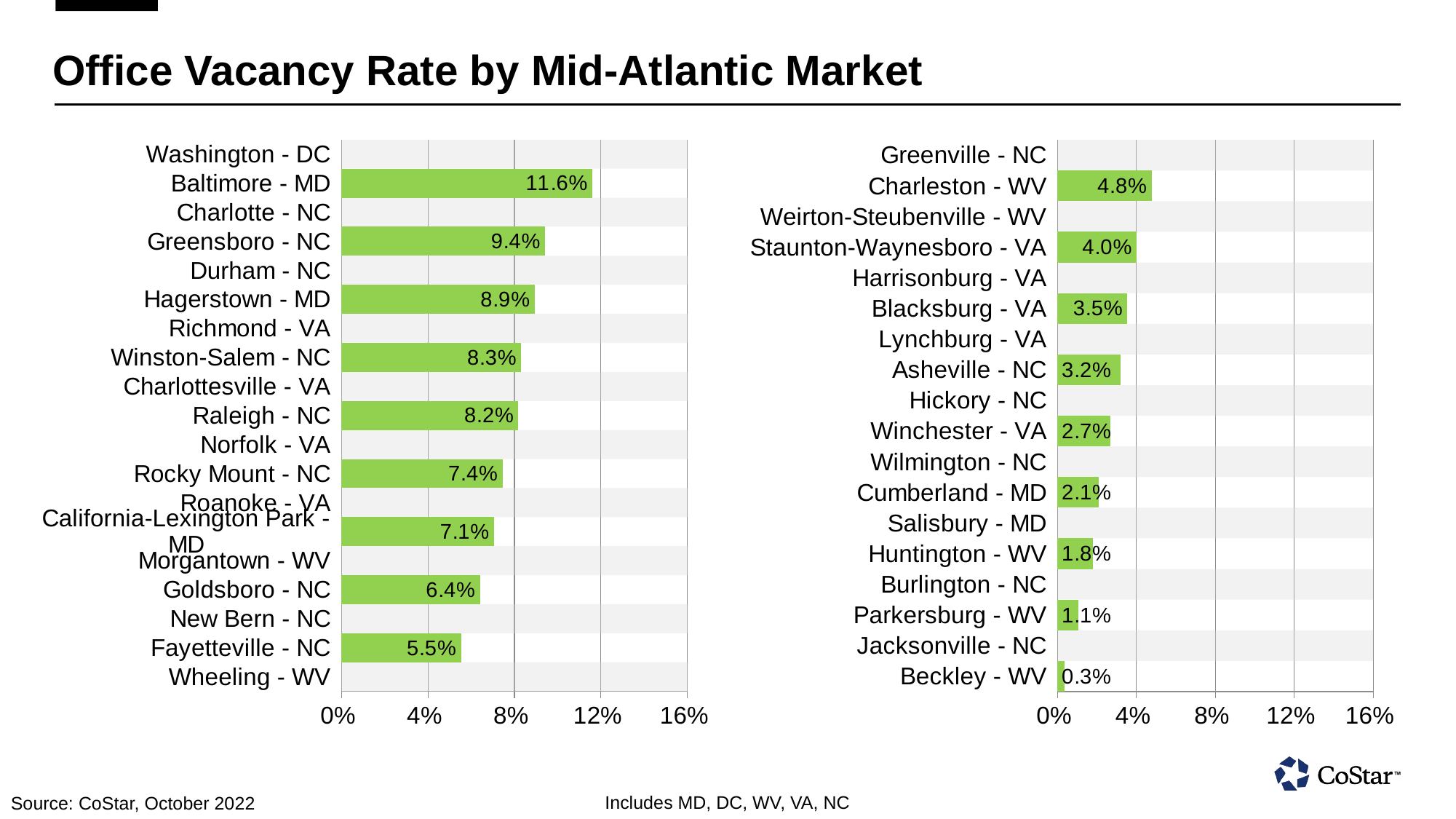
On the right chart, what is the office vacancy rate for Beckley - WV? 0.3% On the right chart, how many bars have a data label printed? 9 What kind of chart is used on the left side of the slide? Bar chart On the left chart, what is the difference between the vacancy rates of Greensboro - NC and Fayetteville - NC? 3.9% On the left chart, is the value for Hagerstown - MD greater or less than 8%? greater On the right chart, which market has the shortest bar? Beckley - WV On the right chart, what is the office vacancy rate for Charleston - WV? 4.8% On the left chart, what is the office vacancy rate for Baltimore - MD? 11.6% On the right chart, which is larger, the vacancy rate for Blacksburg - VA or for Winchester - VA? Blacksburg - VA On the left chart, which market has the longest bar? Baltimore - MD On the left chart, what is the office vacancy rate for Raleigh - NC? 8.2% What is the title of the slide? Office Vacancy Rate by Mid-Atlantic Market